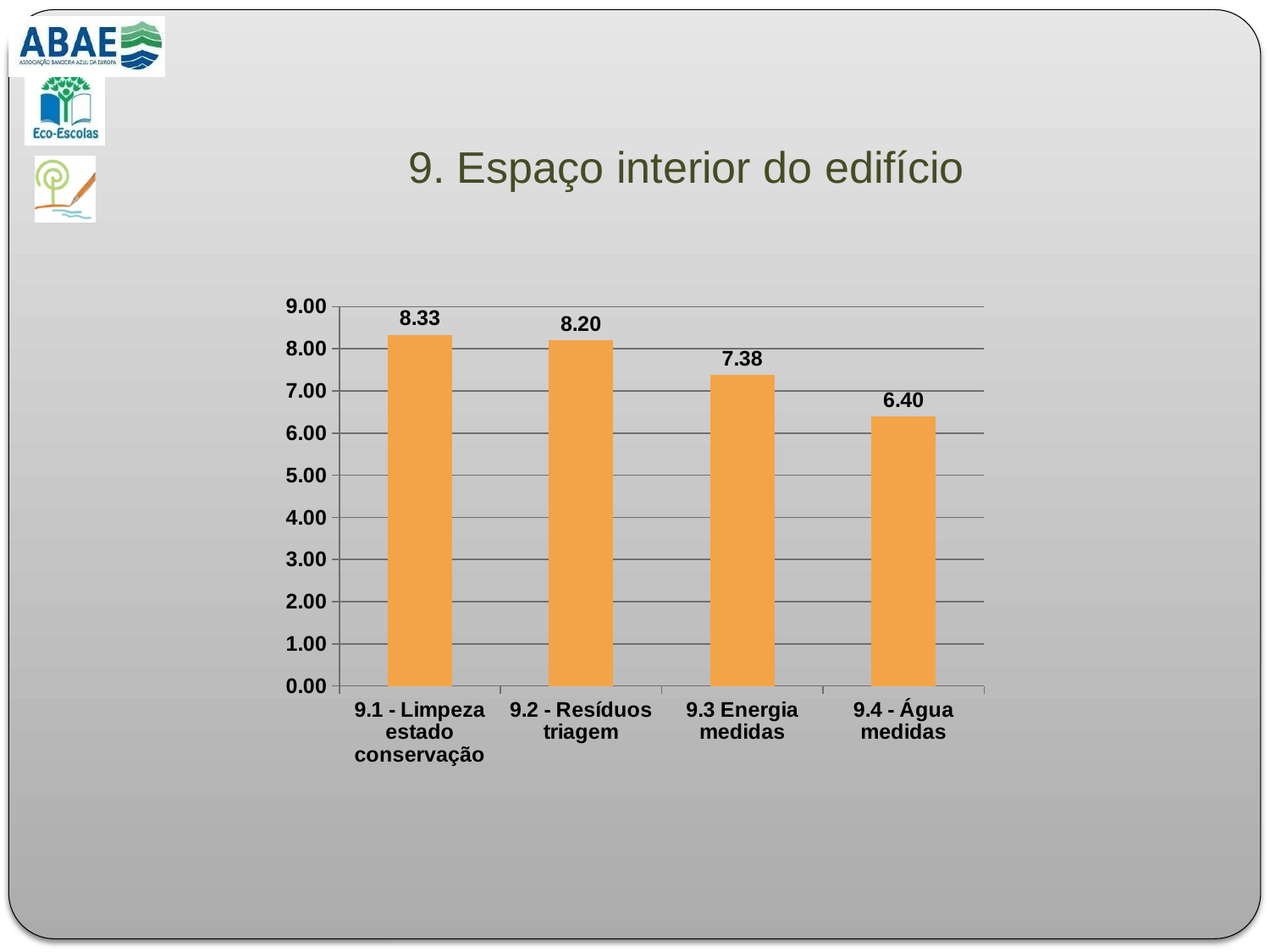
What is the value for 9.4 - Água medidas? 6.40 What is the value for 9.1 - Limpeza estado conservação? 8.33 What kind of chart is shown on the slide? Bar chart Do the values rise or fall from left to right along the x axis? Fall Which category has the lowest value? 9.4 - Água medidas How many categories are shown in the chart? 4 What is the difference between the values for 9.2 - Resíduos triagem and 9.3 Energia medidas? 0.82 What is the value for 9.3 Energia medidas? 7.38 Which is larger, the value for 9.3 Energia medidas or the value for 9.4 - Água medidas? 9.3 Energia medidas What is the value for 9.2 - Resíduos triagem? 8.20 Which category has the highest value? 9.1 - Limpeza estado conservação What is the difference between the values for 9.1 - Limpeza estado conservação and 9.4 - Água medidas? 1.93